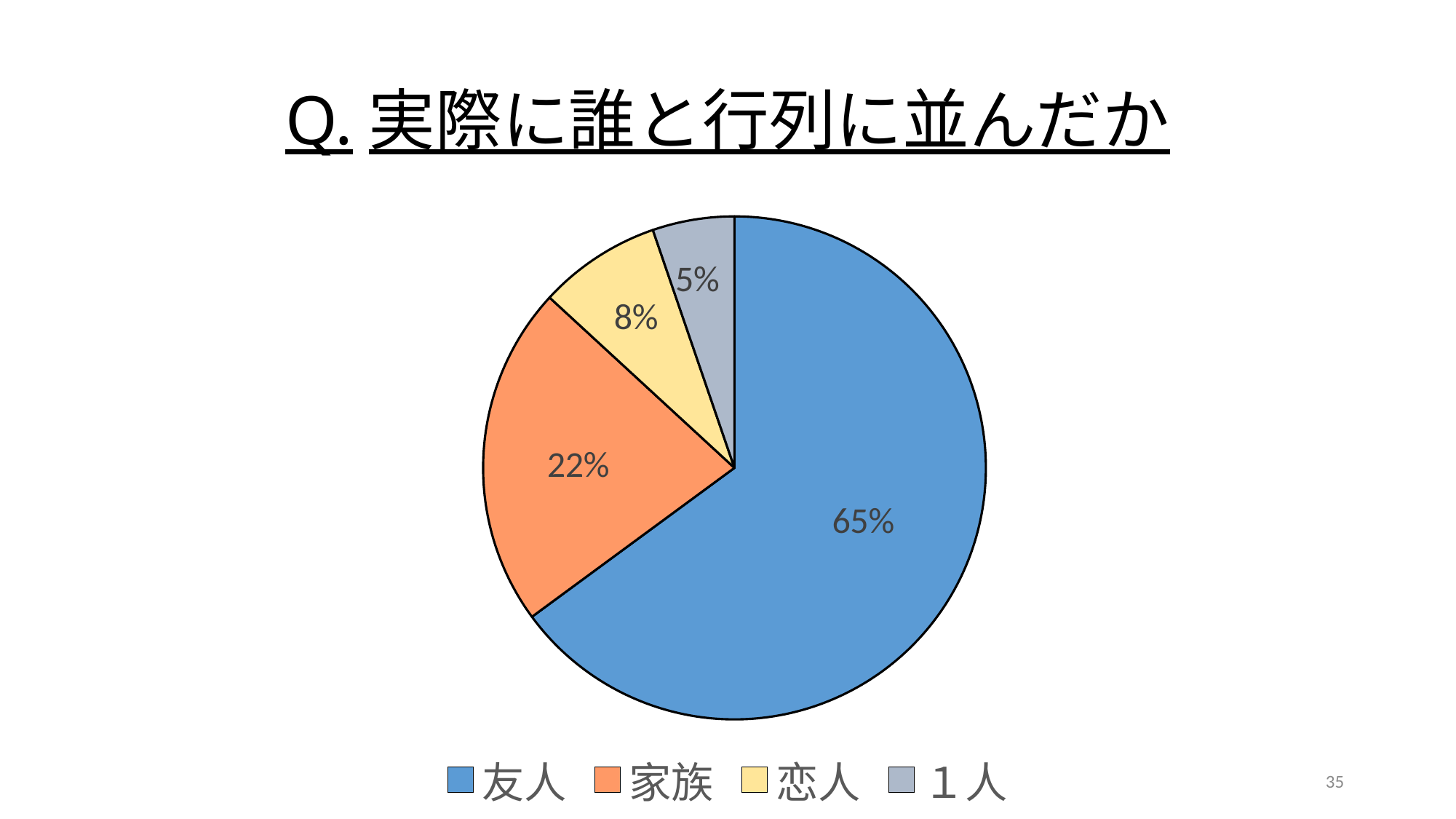
What type of chart is shown on the slide? pie chart How many categories does the pie chart show? 4 What percentage of the pie chart is 家族? 22% What is the title of the chart? Q. 実際に誰と行列に並んだか Which is larger, the share for 家族 or the share for 恋人? 家族 Which category has the largest share of the pie chart? 友人 What percentage of the pie chart is 友人? 65% What percentage of the pie chart is １人? 5% What is the difference in percentage points between 友人 and 家族? 43 Which category has the smallest share of the pie chart? １人 What colour is the slice for 恋人? yellow What percentage of the pie chart is 恋人? 8%